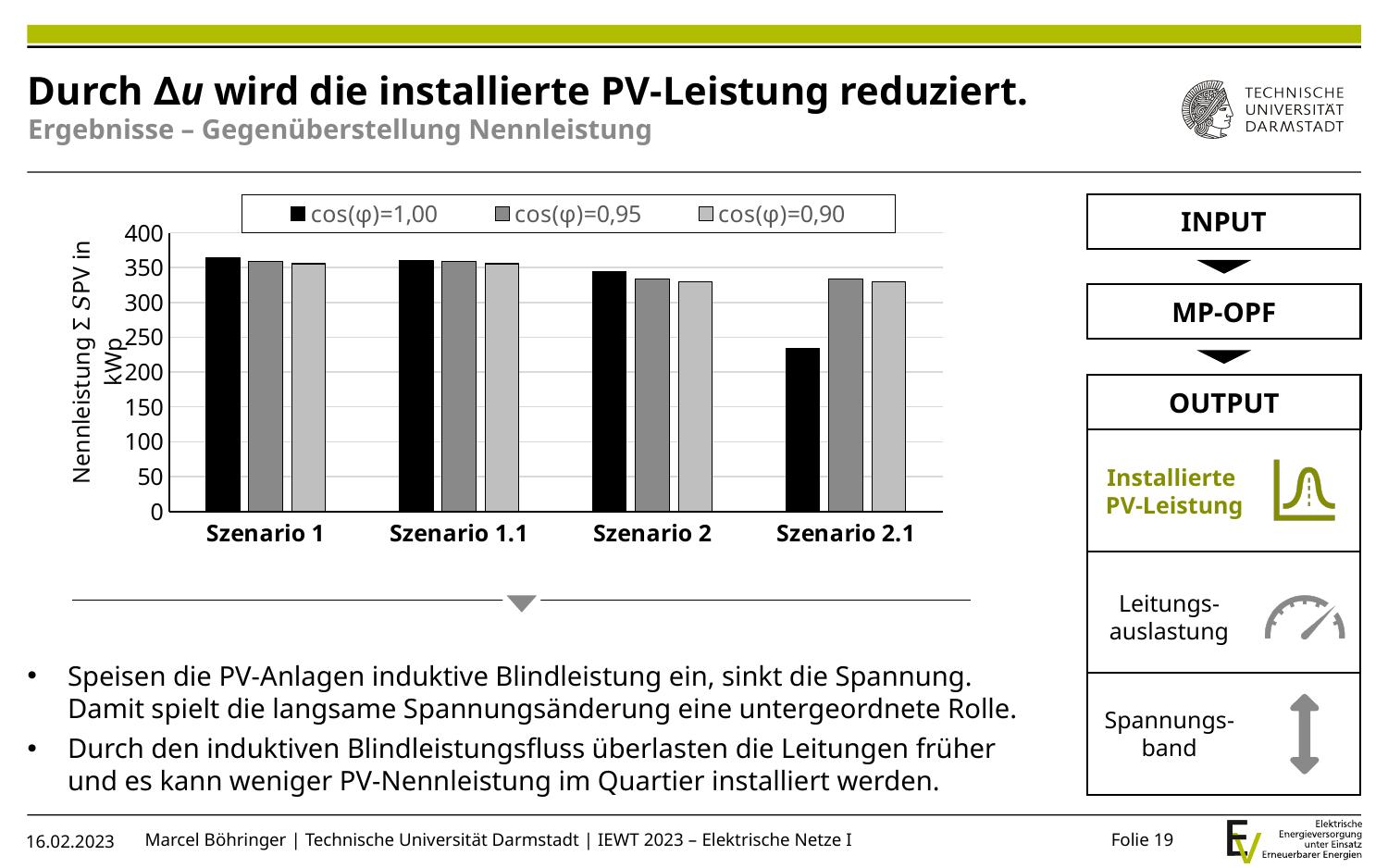
Is the value for cos(φ)=0,90 in Szenario 2 greater or less than 350? less How many scenarios (categories) are shown on the x axis of the chart? 4 Which series is shown with black bars in the chart? cos(φ)=1,00 Do the values for cos(φ)=1,00 rise or fall from Szenario 1 to Szenario 2.1? fall How many series does the chart legend list? 3 What is the label of the y axis of the chart? Nennleistung Σ SPV in kWp Which scenario has the lowest bar for cos(φ)=1,00? Szenario 2.1 In Szenario 2.1, which is larger: the bar for cos(φ)=1,00 or the bar for cos(φ)=0,95? cos(φ)=0,95 Is the value for cos(φ)=1,00 in Szenario 2.1 greater or less than 250? less Is the value for cos(φ)=1,00 in Szenario 1 greater or less than 350? greater What kind of chart is shown on the slide? bar chart